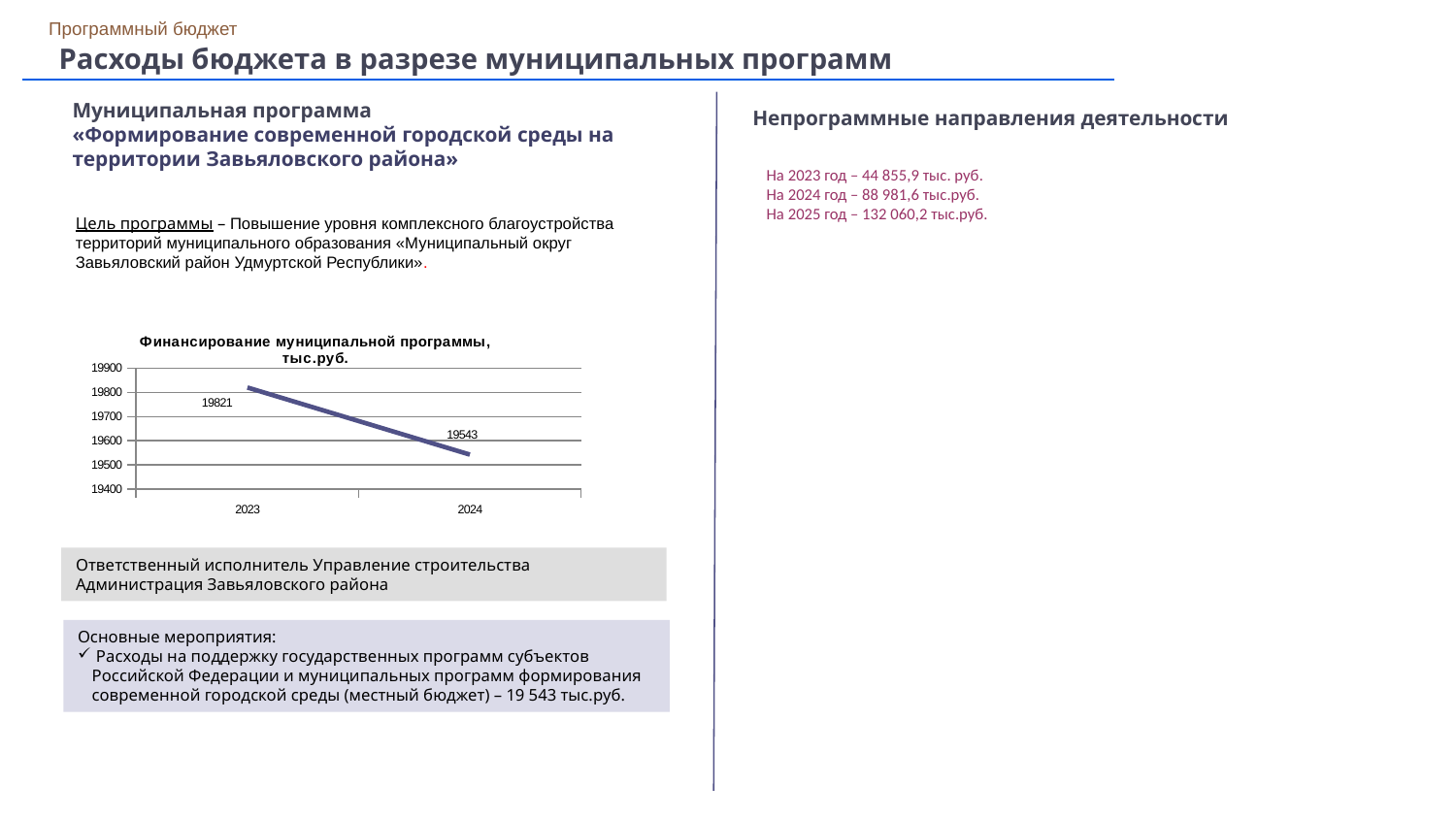
Is the value for 2024 greater or less than 19600? less Which year has the highest value in the chart? 2023 What is the title of the chart on the slide? Финансирование муниципальной программы, тыс.руб. How many data points are plotted in the chart? 2 Is the value for 2023 greater or less than 19700? greater Which year has the lowest value in the chart? 2024 What kind of chart is shown on the slide? line chart What is the difference between the 2023 and 2024 values in the chart? 278 Do the values in the chart rise or fall from 2023 to 2024? fall What is the value for 2023 in the chart "Финансирование муниципальной программы, тыс.руб."? 19821 Which is larger in the chart, the value for 2023 or the value for 2024? 2023 What is the value for 2024 in the chart "Финансирование муниципальной программы, тыс.руб."? 19543